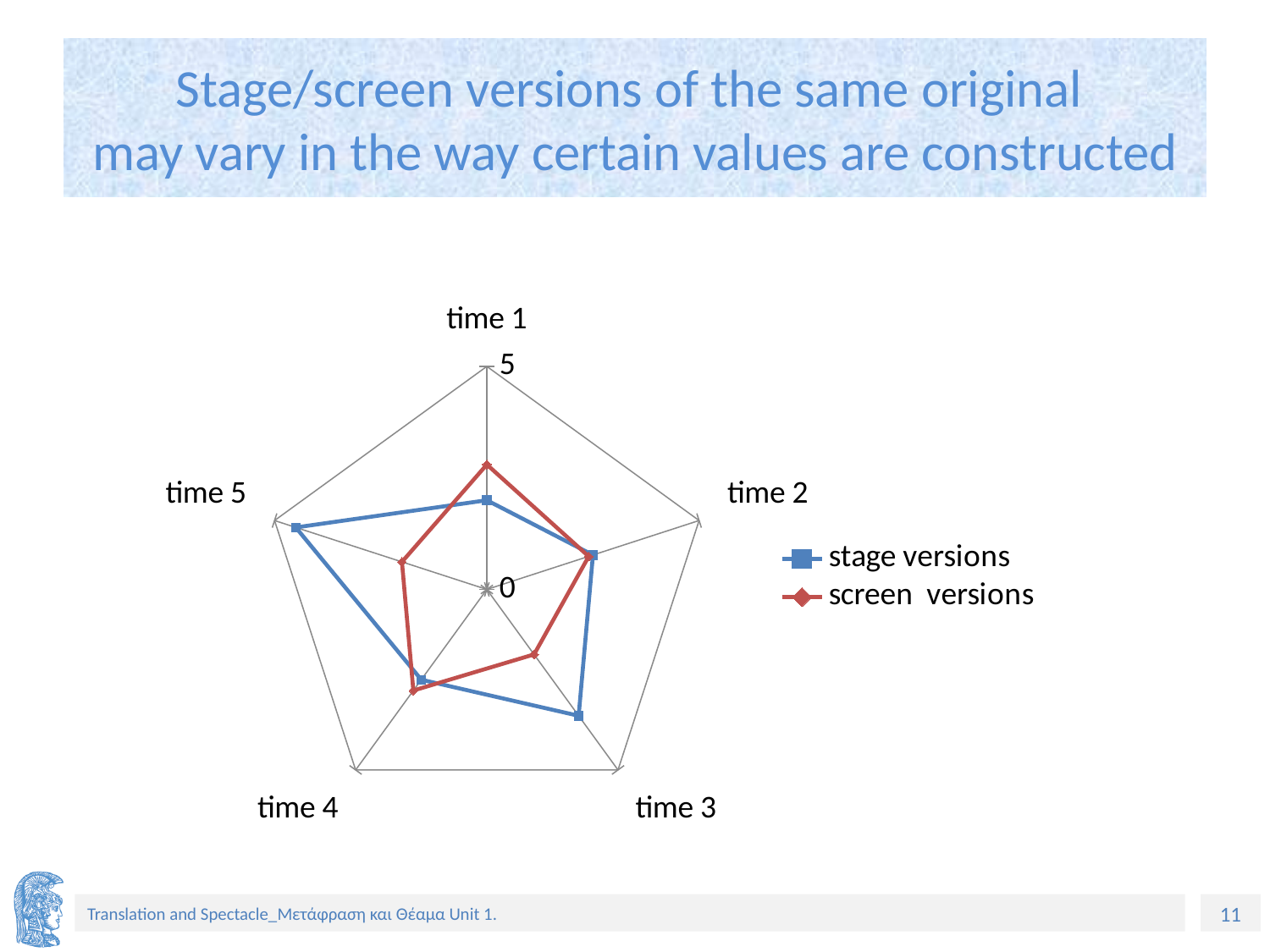
How many series does the legend list? 2 What kind of chart is shown on the slide? Radar chart Which series is drawn in red with diamond markers? screen versions At time 5, which series has the larger value, stage versions or screen versions? stage versions At time 3, which series has the larger value, stage versions or screen versions? stage versions How many categories (axes) does the radar chart have? 5 Which series is drawn in blue with square markers? stage versions What is the maximum value shown on the radar chart's axis? 5 For the stage versions series, which category has the highest value? time 5 At time 1, which series has the larger value, stage versions or screen versions? screen versions Is the value for time 5 in the stage versions series greater or less than 5? less